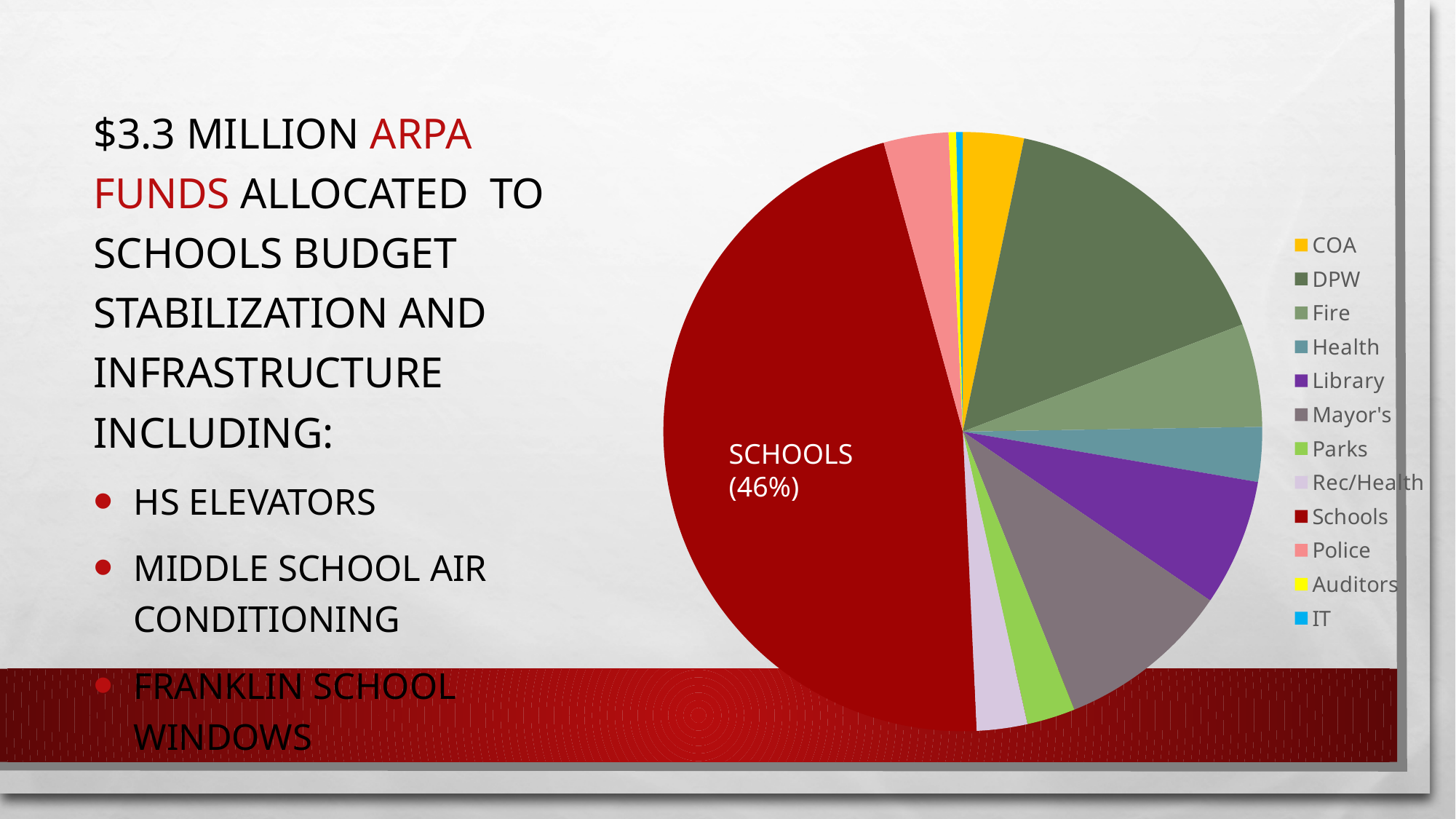
What kind of chart is shown on the slide? pie chart How many entries does the legend of the pie chart list? 12 Which slice of the pie chart has a data label printed on it? Schools How many slices does the pie chart have? 12 Which category has the smallest slice of the pie chart? IT Which category has the largest slice of the pie chart? Schools Which slice is larger, Police or IT? Police Which slice is larger, Mayor's or Parks? Mayor's What share of the pie does the Schools slice represent? 46% Which slice is larger, Library or Health? Library What colour is the Schools slice in the pie chart? red